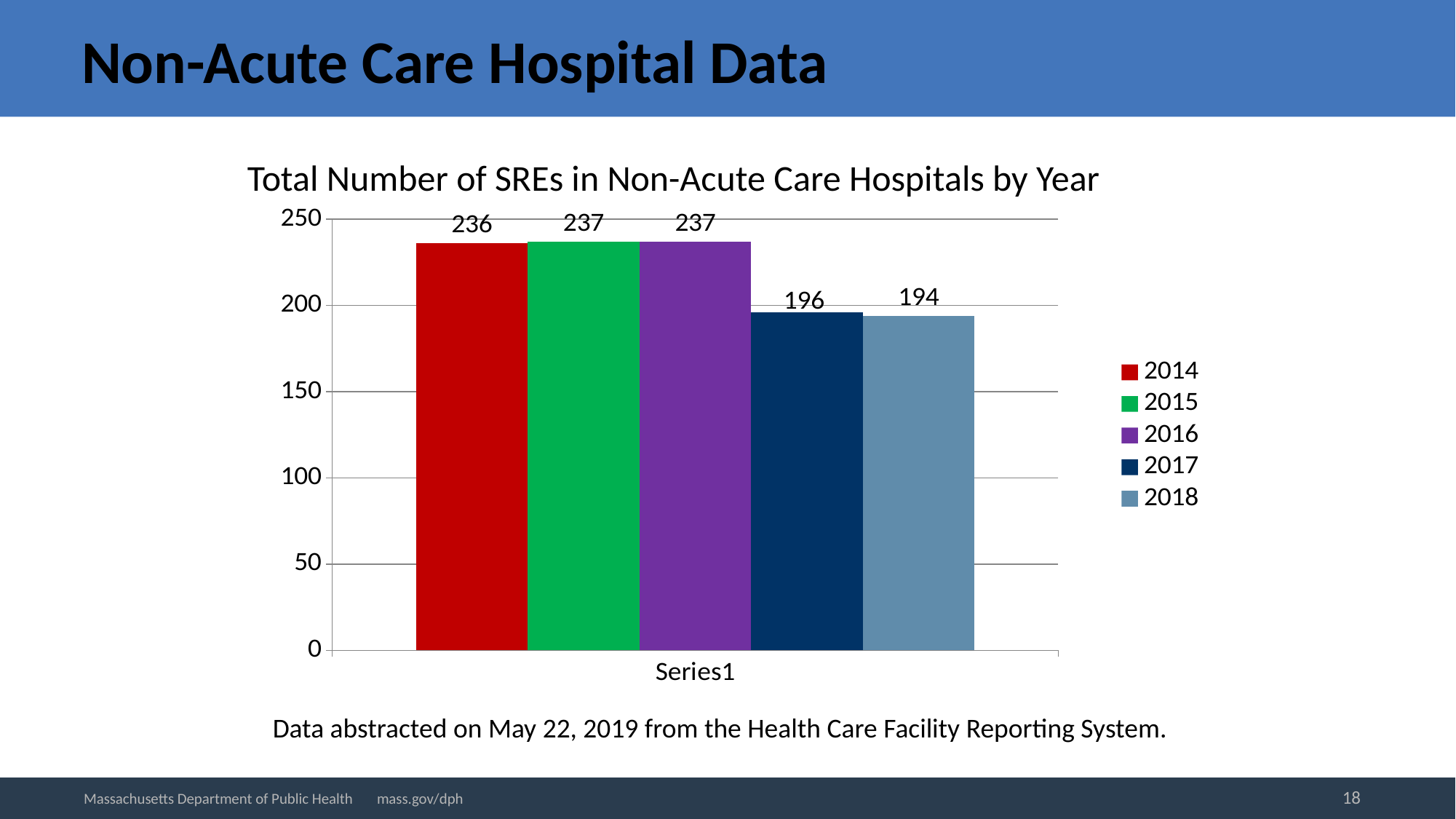
What is the difference between the number of SREs in 2016 and in 2017? 41 What is the total number of SREs in non-acute care hospitals for 2017? 196 Which year had more SREs, 2014 or 2017? 2014 What is the title of the chart? Total Number of SREs in Non-Acute Care Hospitals by Year Do the SRE counts generally rise or fall from 2014 to 2018? Fall What is the difference between the number of SREs in 2014 and in 2018? 42 Which year has the lowest total number of SREs? 2018 How many years are shown in the legend? 5 What is the total number of SREs in non-acute care hospitals for 2014? 236 What is the total number of SREs in non-acute care hospitals for 2015? 237 What type of chart is shown on the slide? Bar chart What is the total number of SREs in non-acute care hospitals for 2018? 194